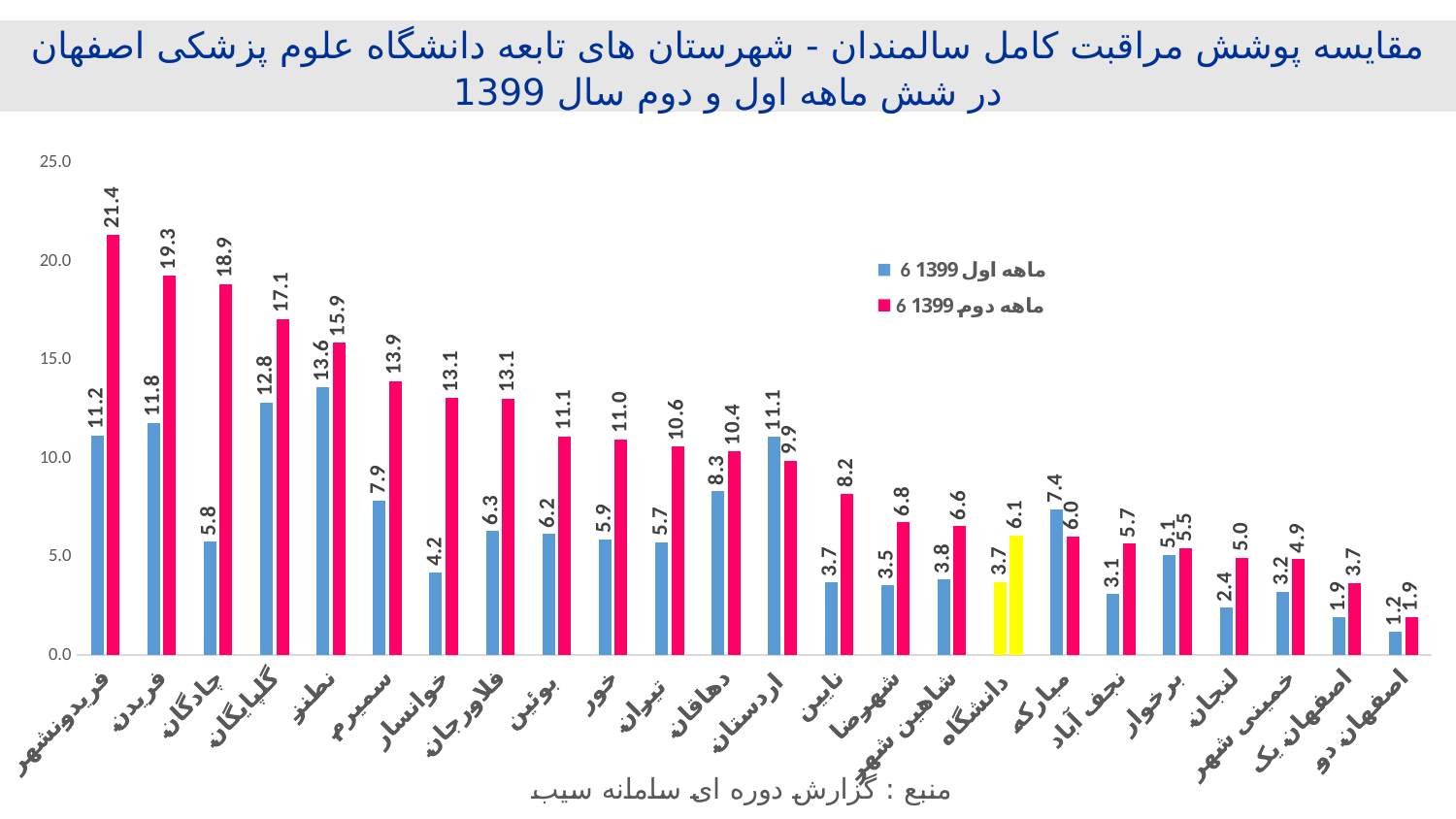
How many series does the legend list? 2 What is the value for چادگان in the 6 ماهه اول 1399 series? 5.8 What is the value for دانشگاه in the 6 ماهه دوم 1399 series? 6.1 Is the 6 ماهه دوم 1399 value for نطنز greater or less than 15.0? greater What is the difference between the 6 ماهه دوم 1399 and 6 ماهه اول 1399 values for چادگان? 13.1 What kind of chart is shown on the slide? bar chart For اردستان, which series has the larger value: 6 ماهه اول 1399 or 6 ماهه دوم 1399? 6 ماهه اول 1399 What is the value for فریدونشهر in the 6 ماهه دوم 1399 series? 21.4 Which category's bar is highlighted in yellow? دانشگاه How many categories are shown on the x axis? 24 Which category has the highest value in the 6 ماهه دوم 1399 series? فریدونشهر Which category has the lowest value in the 6 ماهه اول 1399 series? اصفهان دو